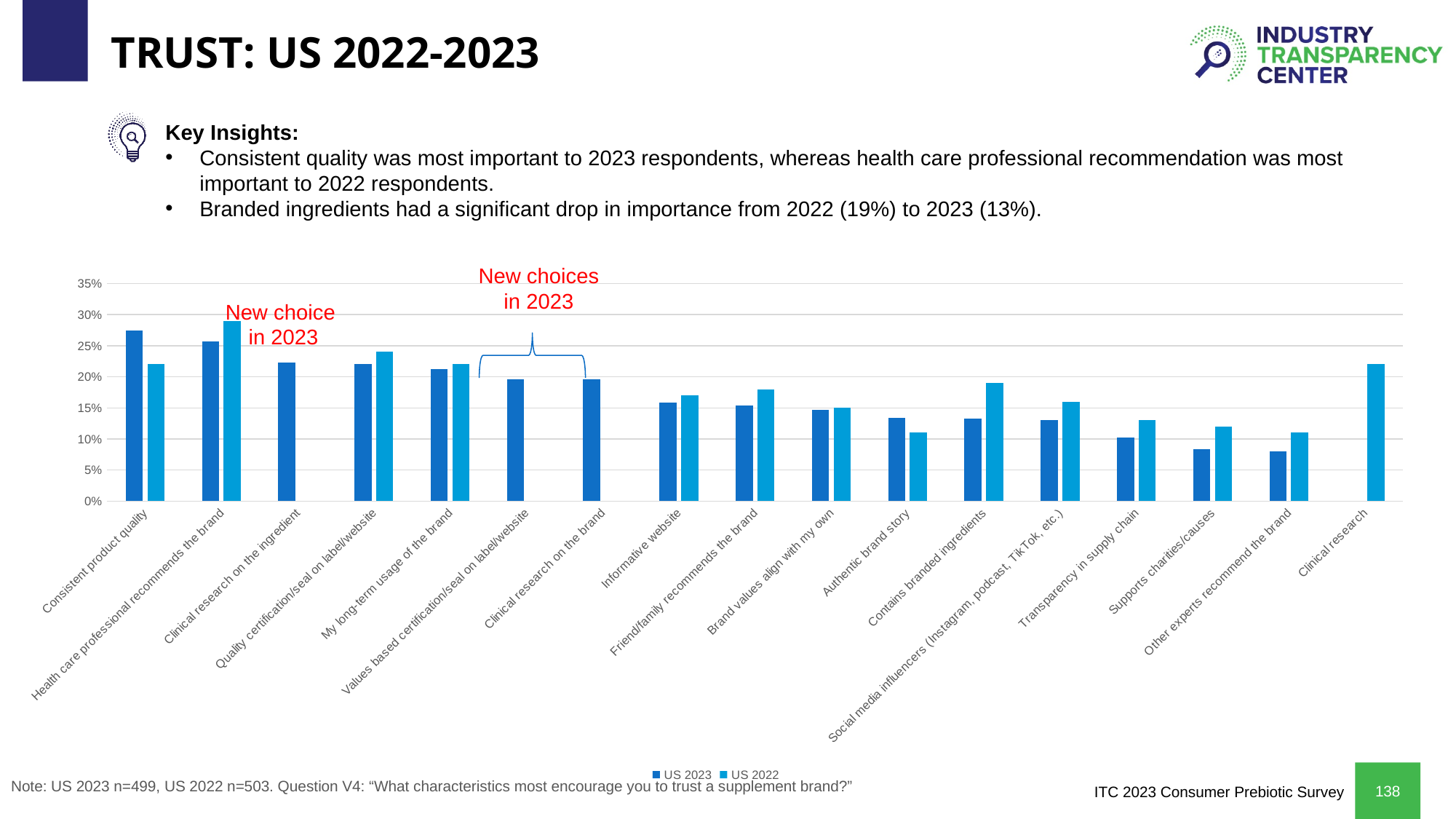
How many categories are shown on the x axis of the chart? 17 For Consistent product quality, which series has the larger value, US 2023 or US 2022? US 2023 What kind of chart is shown on the slide? bar chart Which category has the highest US 2022 value? Health care professional recommends the brand What are the two series names listed in the chart legend? US 2023 and US 2022 Is the US 2023 value for Consistent product quality greater or less than 25%? greater Which category has the highest US 2023 value? Consistent product quality How many series does the chart legend list? 2 What was the US 2023 value for Contains branded ingredients? 13% Is the US 2023 value for Other experts recommend the brand greater or less than 10%? less What was the US 2022 value for Contains branded ingredients? 19% By how many percentage points did Contains branded ingredients drop from US 2022 to US 2023? 6 percentage points